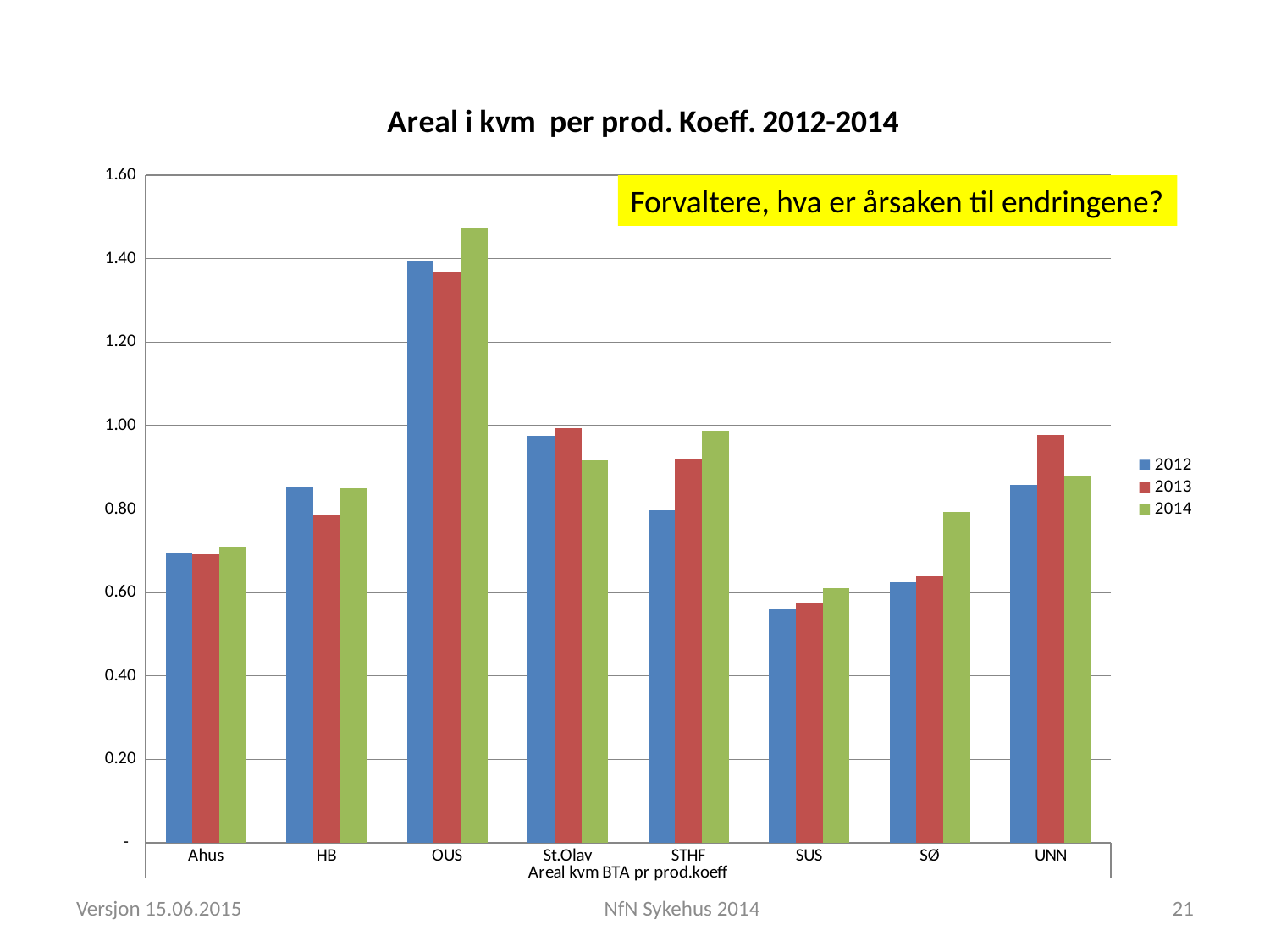
Is the 2012 value for SUS greater or less than 0.60? less How many hospital categories are shown on the x axis? 8 Is the 2014 value for St.Olav greater or less than 0.80? greater What kind of chart is shown on the slide? bar chart What is the title of the chart? Areal i kvm per prod. Koeff. 2012-2014 Is the 2014 value for OUS greater or less than 1.40? greater Which category has the lowest value for 2012? SUS Do the values for SØ rise or fall from 2012 to 2014? rise Which category has the highest value for 2014? OUS For STHF, which is larger: the 2012 value or the 2013 value? 2013 For SØ, which is larger: the 2013 value or the 2014 value? 2014 How many series does the legend list? 3